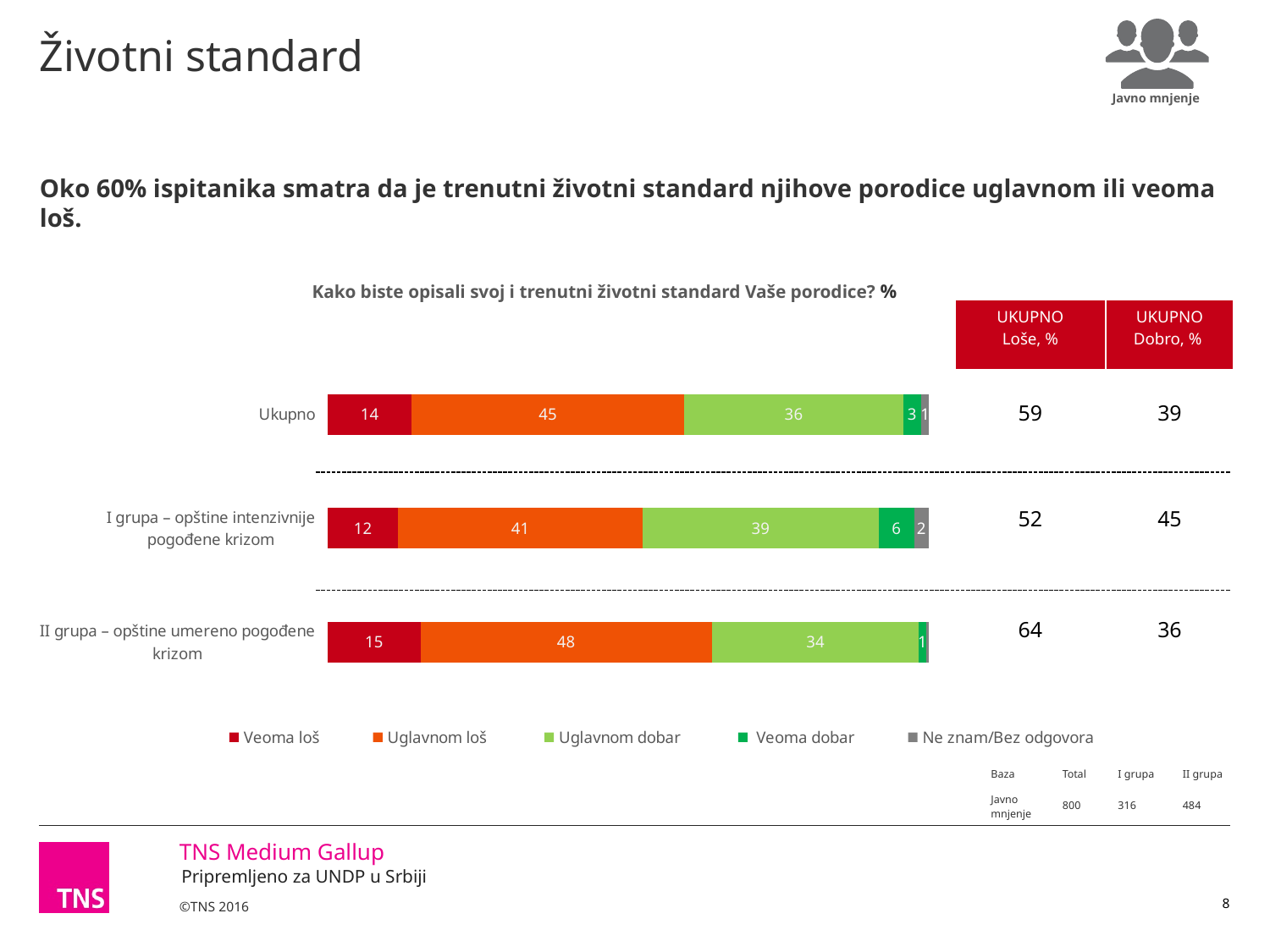
Which category has the lowest value for 'Veoma loš'? I grupa – opštine intenzivnije pogođene krizom How many categories (groups) are plotted in the chart? 3 What is the value of 'Uglavnom dobar' for 'I grupa – opštine intenzivnije pogođene krizom'? 39 Which category has the highest value for 'Uglavnom loš'? II grupa – opštine umereno pogođene krizom What is the difference between the 'Uglavnom loš' values for 'II grupa' and 'I grupa'? 7 Which is larger: the 'Veoma dobar' value for 'I grupa' or for 'Ukupno'? I grupa What is the value of 'Uglavnom loš' for the 'Ukupno' category? 45 How many series does the chart legend list? 5 What is the value of 'Veoma loš' for 'II grupa – opštine umereno pogođene krizom'? 15 What type of chart is shown on the slide? stacked bar chart According to the 'UKUPNO Loše, %' column, what is the value for 'II grupa – opštine umereno pogođene krizom'? 64 What is the title of the chart? Kako biste opisali svoj i trenutni životni standard Vaše porodice? %